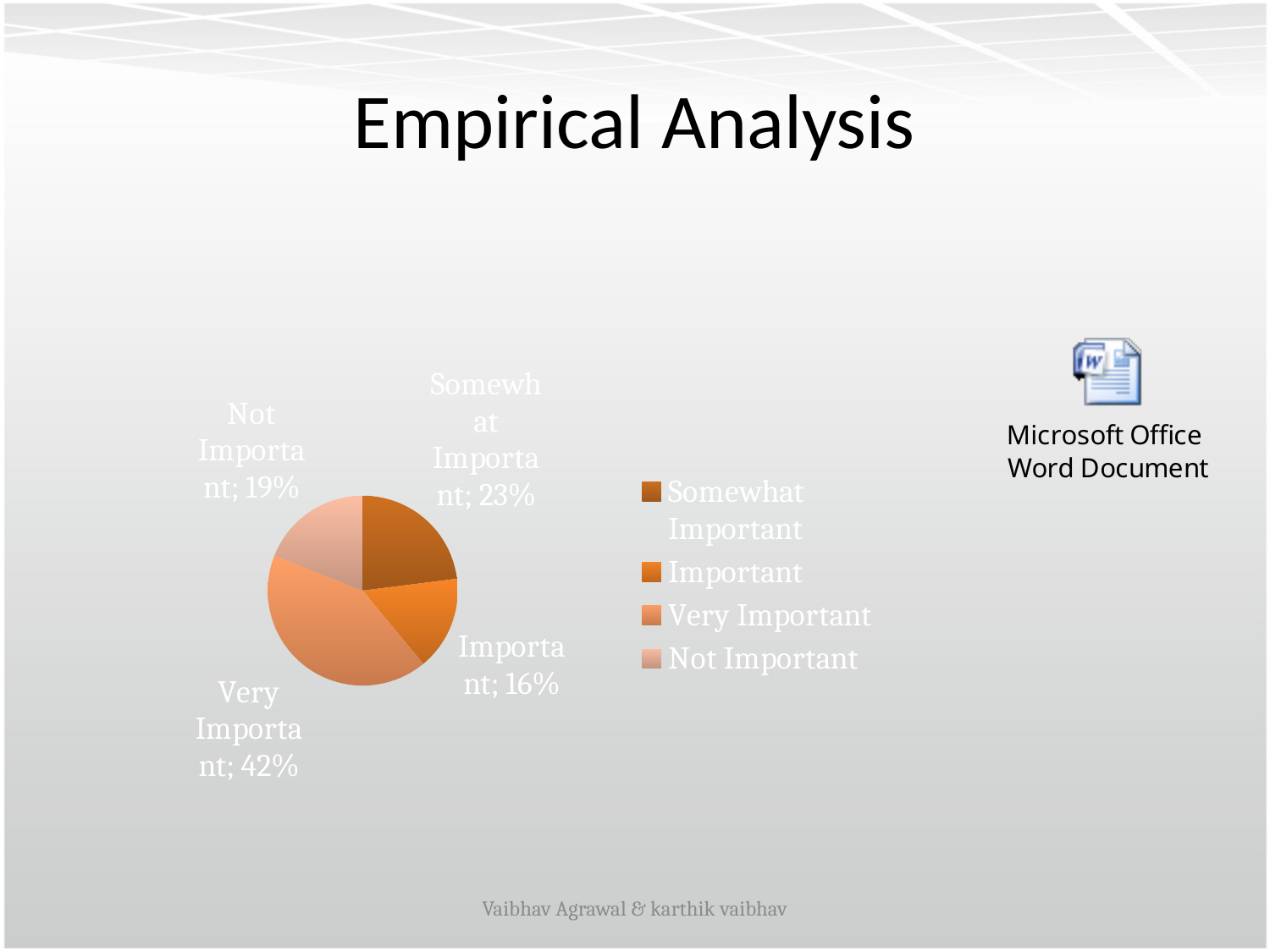
Which slice is larger, Somewhat Important or Not Important? Somewhat Important Which category has the largest slice of the pie? Very Important What percentage is shown for the Somewhat Important slice? 23% How many entries does the legend list? 4 What percentage is shown for the Very Important slice? 42% How many slices does the pie chart have? 4 What is the difference in percentage points between the Very Important and Important slices? 26 What percentage is shown for the Not Important slice? 19% Which category has the smallest slice of the pie? Important Which legend entry is listed first? Somewhat Important What kind of chart is shown on the slide? pie chart What percentage is shown for the Important slice? 16%